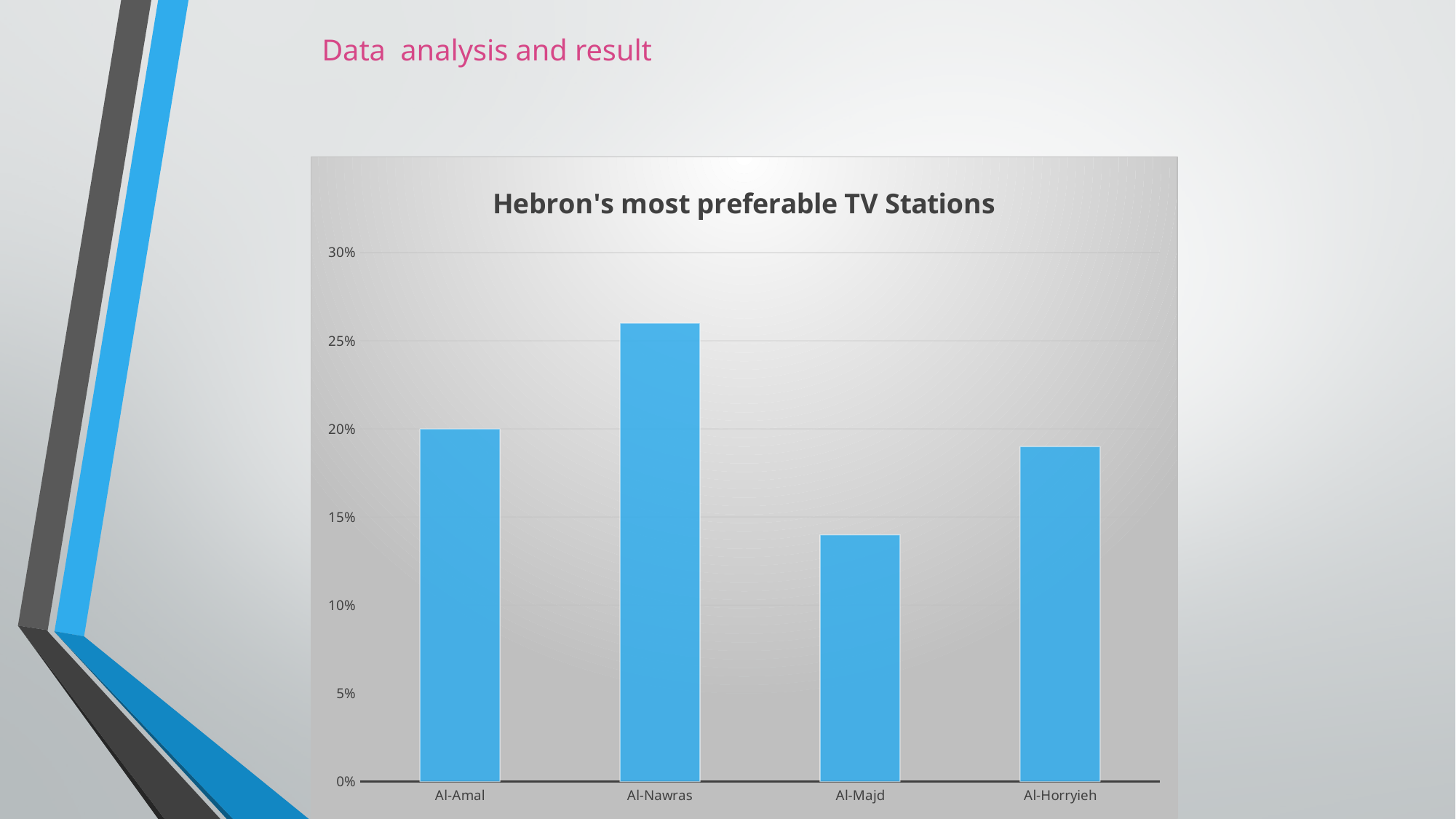
How many TV stations are shown on the chart? 4 Which has a larger value, Al-Nawras or Al-Amal? Al-Nawras Is the value for Al-Nawras greater or less than 25%? greater What is the title of the chart? Hebron's most preferable TV Stations Which TV station has the lowest value? Al-Majd What is the value for Al-Amal? 20% Is the value for Al-Majd greater or less than 15%? less Is the value for Al-Horryieh greater or less than 20%? less What kind of chart is shown on the slide? bar chart Which TV station has the highest value? Al-Nawras What colour are the bars in the chart? blue